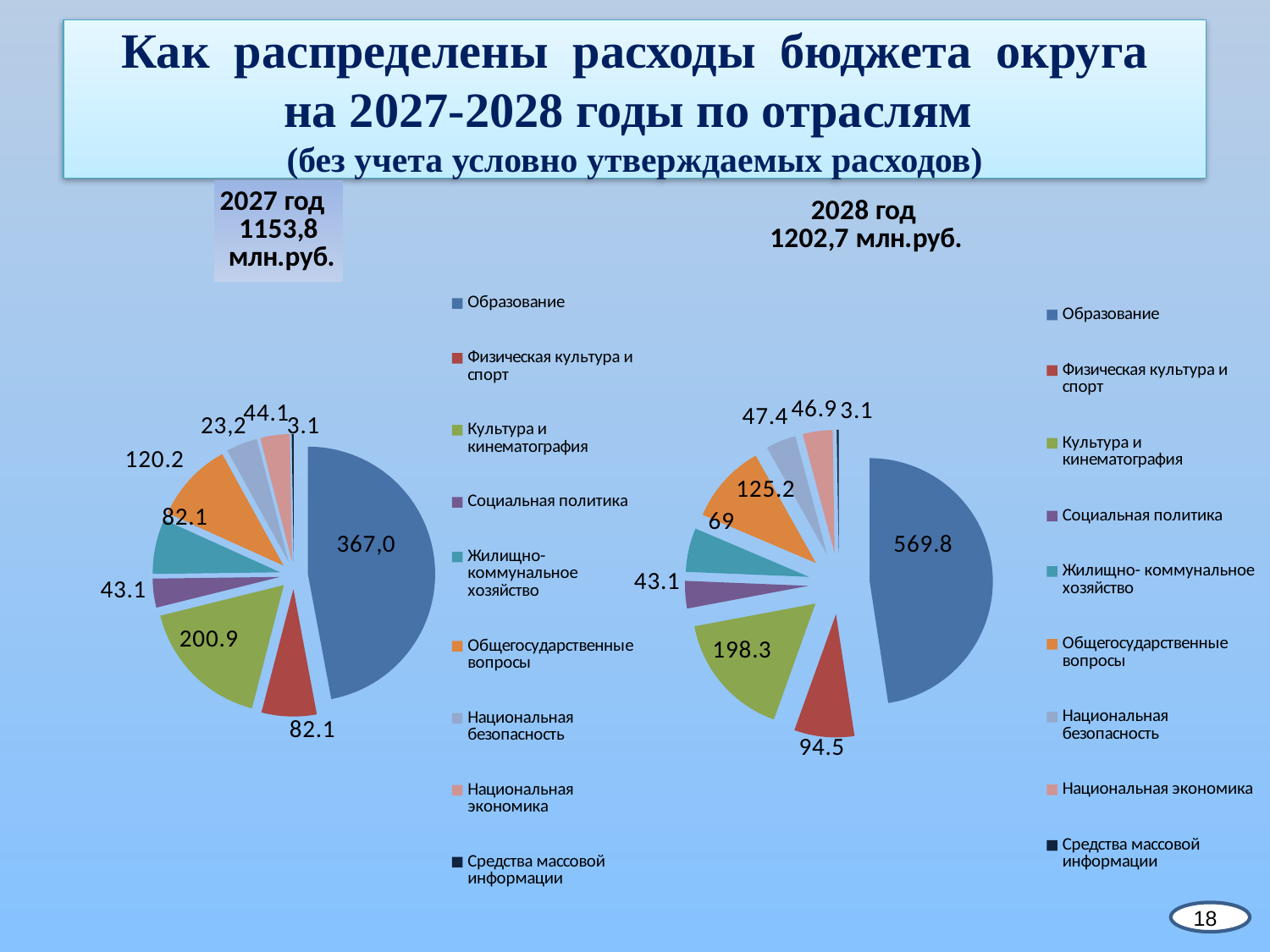
In the 2028 pie chart, which category has the largest slice? Образование What type of chart is used for the 2028 data? Pie chart In the 2027 pie chart, what is the difference between Культура и кинематография and Общегосударственные вопросы? 80.7 In the 2028 pie chart, which is larger: Физическая культура и спорт or Жилищно-коммунальное хозяйство? Физическая культура и спорт In the 2027 pie chart, what is the value for Образование? 367,0 How many slices does the 2027 pie chart have? 9 How much larger is the value for Образование in the 2028 pie chart than in the 2027 pie chart? 202.8 In the 2028 pie chart, what is the value for Образование? 569.8 In the 2028 pie chart, what is the value for Общегосударственные вопросы? 125.2 In the 2027 pie chart, which category has the smallest slice? Средства массовой информации In the 2028 pie chart, what is the value for Жилищно-коммунальное хозяйство? 69 In the 2027 pie chart, what is the value for Культура и кинематография? 200.9